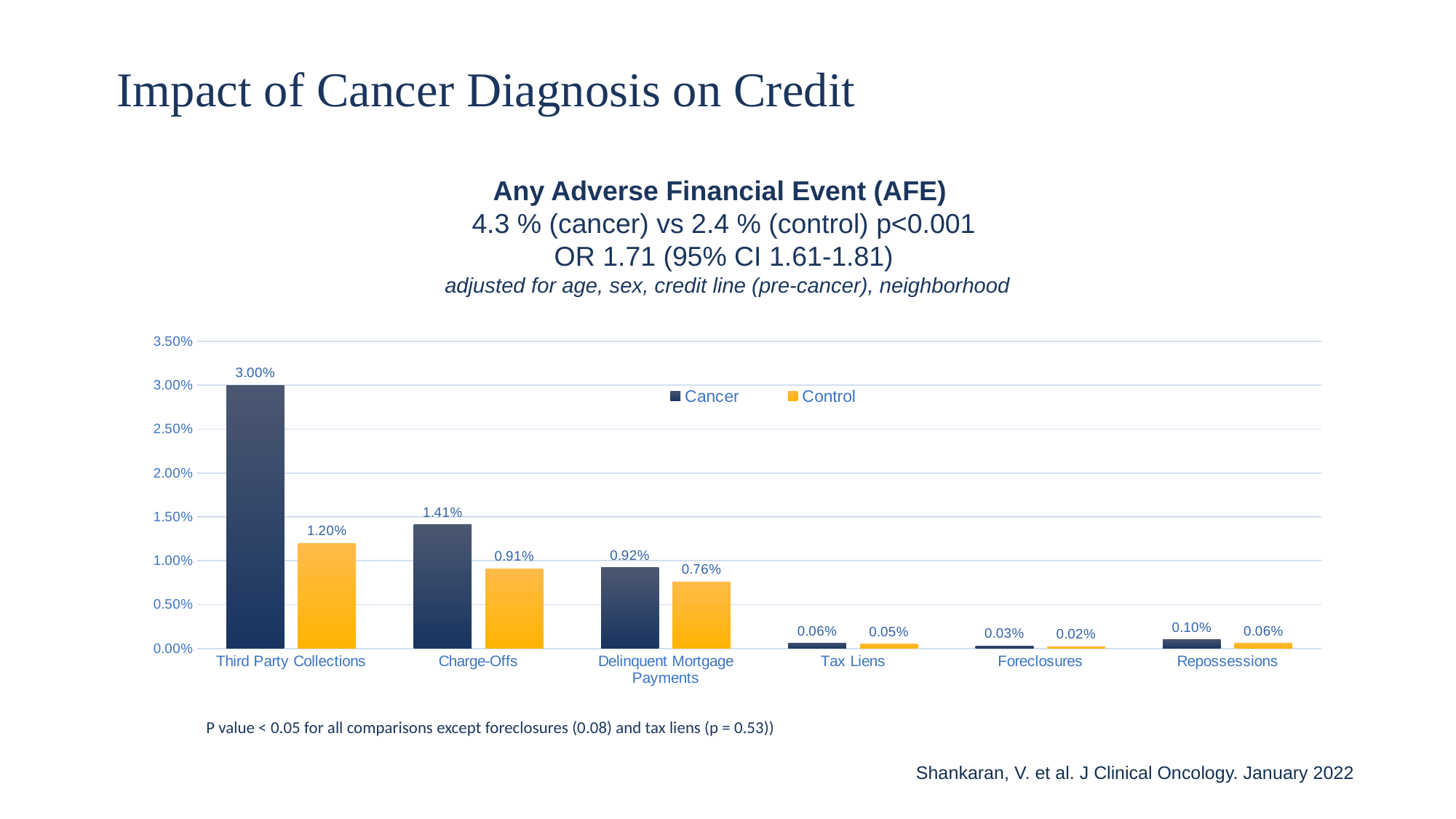
How many categories are shown on the x axis? 6 What is the difference between the Cancer and Control values for Third Party Collections? 1.80% What is the Cancer value for Third Party Collections? 3.00% Which category has the lowest Control value? Foreclosures What is the Control value for Repossessions? 0.06% Which category has the highest Cancer value? Third Party Collections What kind of chart is shown on the slide? Bar chart What is the Control value for Charge-Offs? 0.91% Which is larger for Charge-Offs, the Cancer value or the Control value? Cancer Which series is shown in orange in the legend? Control How many series does the legend list? 2 What is the Cancer value for Delinquent Mortgage Payments? 0.92%